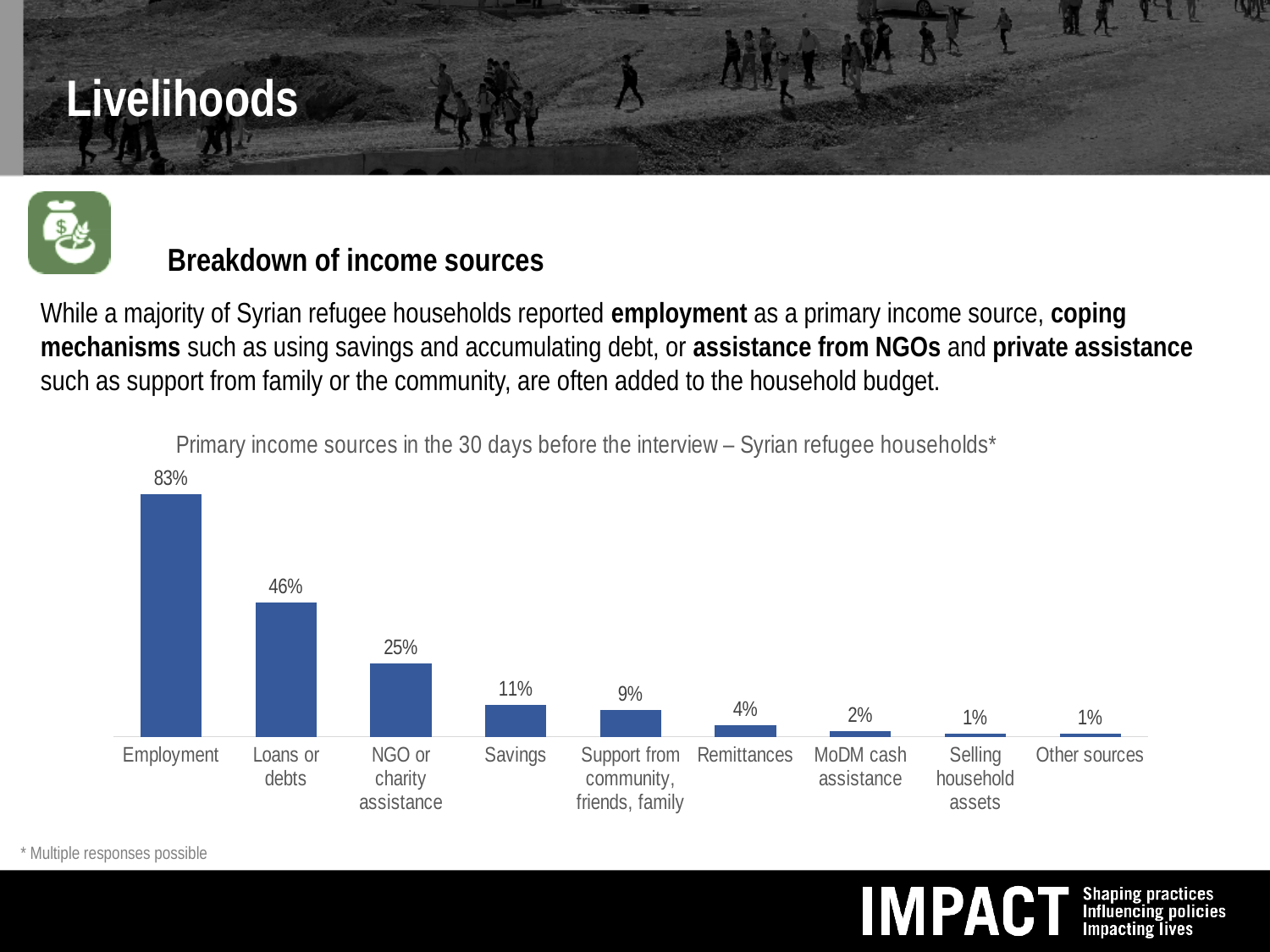
What is the difference between the values for Employment and Loans or debts? 37% What is the value shown for Loans or debts? 46% Do the values rise or fall moving from left to right along the x axis? Fall What kind of chart is shown on the slide? Bar chart What is the value shown for Remittances? 4% What percentage of Syrian refugee households reported Employment as a primary income source? 83% What is the value shown for NGO or charity assistance? 25% Which income source has the highest value in the chart? Employment Which is larger, the value for Savings or the value for Remittances? Savings How many income source categories are shown in the chart? 9 What is the difference between the values for Savings and Support from community, friends, family? 2% What is the title of the chart? Primary income sources in the 30 days before the interview – Syrian refugee households*